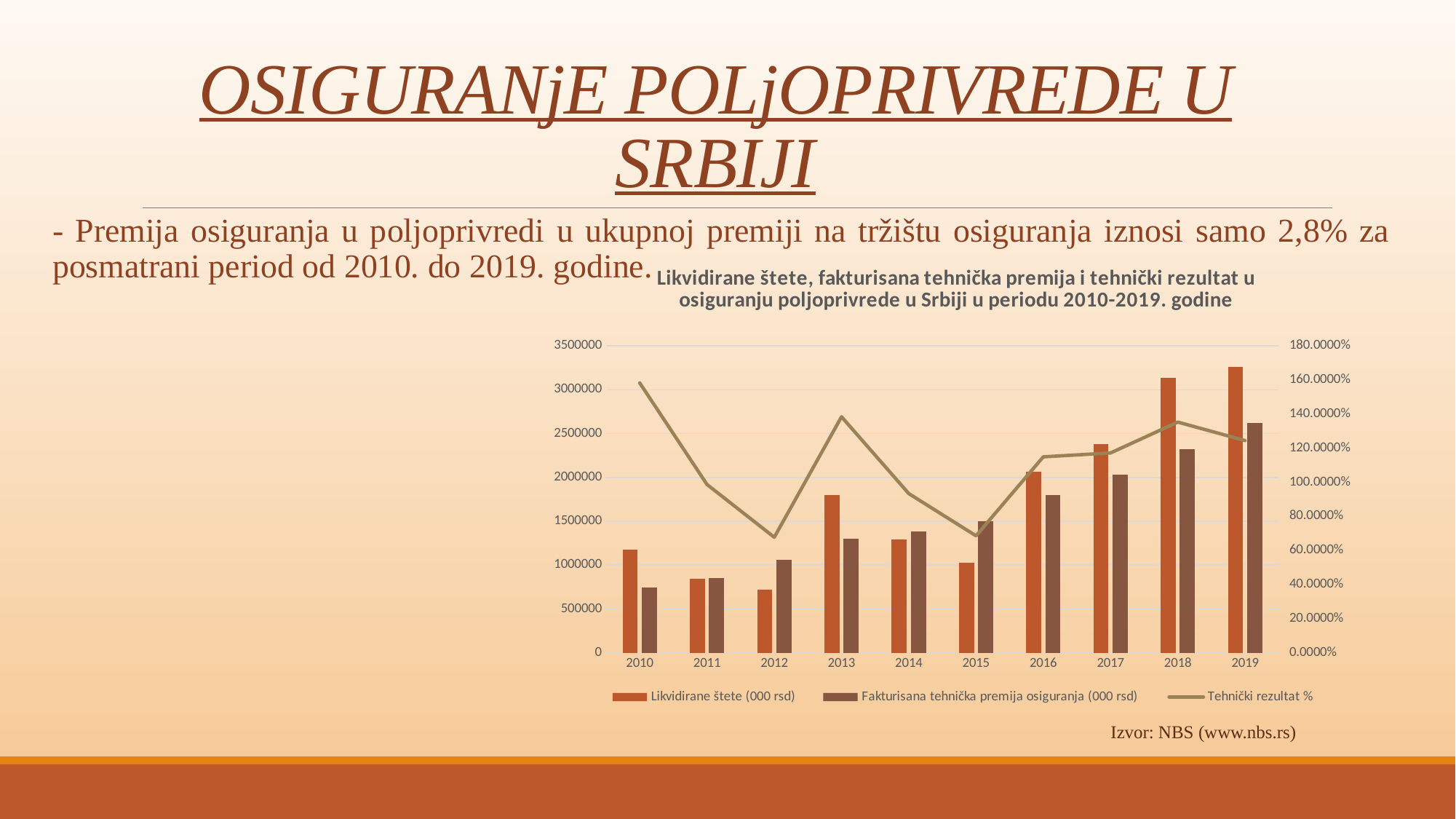
Is the Tehnički rezultat % for 2012 greater or less than 80.0000%? less Is the value of Fakturisana tehnička premija osiguranja (000 rsd) for 2019 greater or less than 2500000? greater In which year is Fakturisana tehnička premija osiguranja (000 rsd) the lowest? 2010 In which year is the value of Likvidirane štete (000 rsd) the lowest? 2012 Is the value of Likvidirane štete (000 rsd) for 2018 greater or less than 3000000? greater In 2015, which is larger: Likvidirane štete (000 rsd) or Fakturisana tehnička premija osiguranja (000 rsd)? Fakturisana tehnička premija osiguranja (000 rsd) Does Fakturisana tehnička premija osiguranja (000 rsd) rise or fall from 2010 to 2019? rise In which year is Tehnički rezultat % the highest? 2010 What kind of chart is shown on the slide? A combined bar and line chart In which year is the value of Likvidirane štete (000 rsd) the highest? 2019 How many series does the chart legend list? 3 How many years are shown on the x axis of the chart? 10